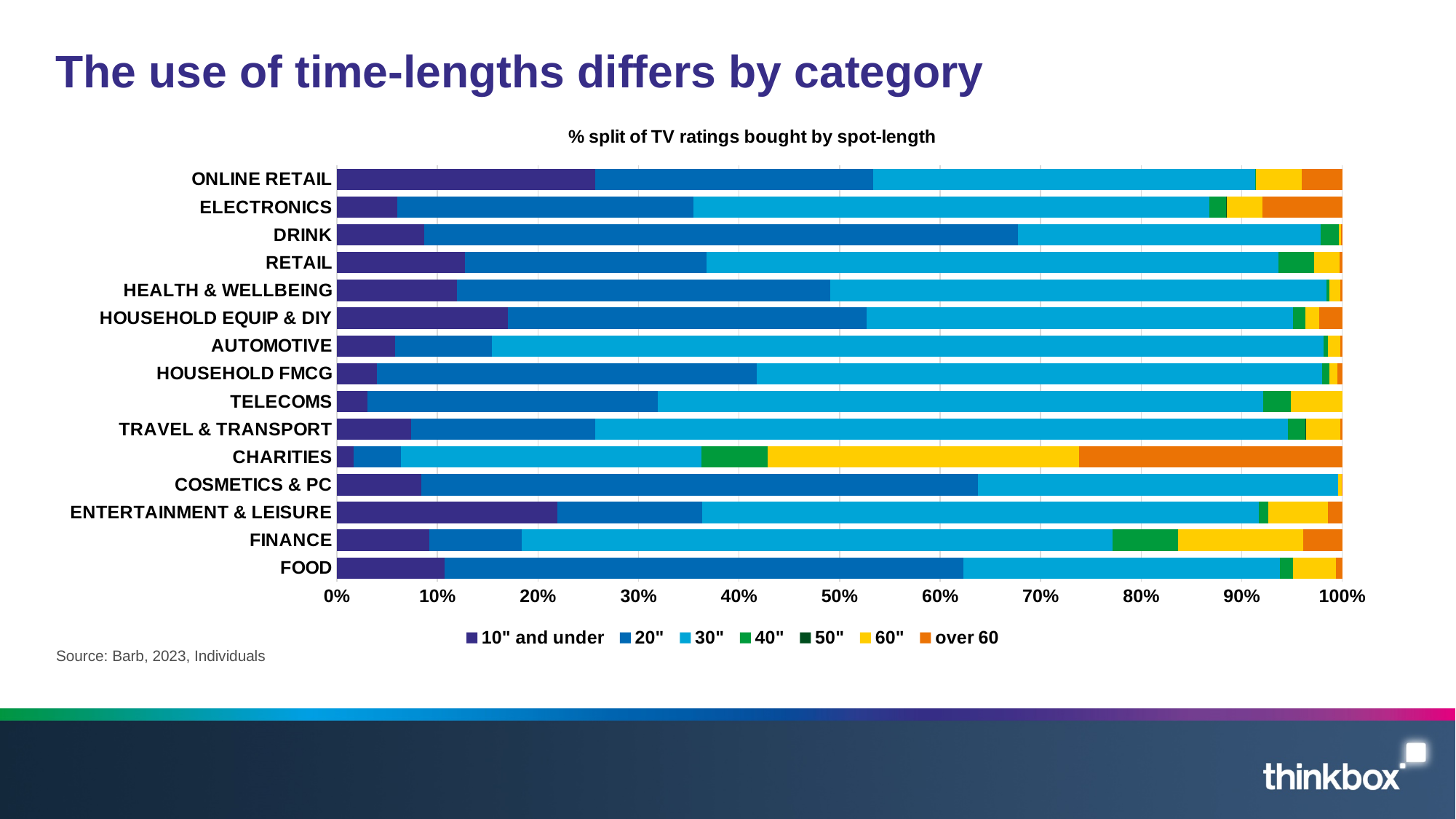
What kind of chart is shown on the slide? Stacked bar chart Which category has the largest share for "over 60"? CHARITIES How many categories are plotted on the chart? 15 Which category has the largest share for "10" and under"? ONLINE RETAIL What is the title of the chart? % split of TV ratings bought by spot-length Which series is shown in orange in the legend? over 60 Which has the larger "over 60" share, CHARITIES or FOOD? CHARITIES Which category has the smallest share for "10" and under"? CHARITIES Which category has the largest share for "60""? CHARITIES How many series does the legend list? 7 Is the "10" and under" share for ONLINE RETAIL greater or less than 20%? greater Is the "10" and under" share for ELECTRONICS greater or less than 10%? less